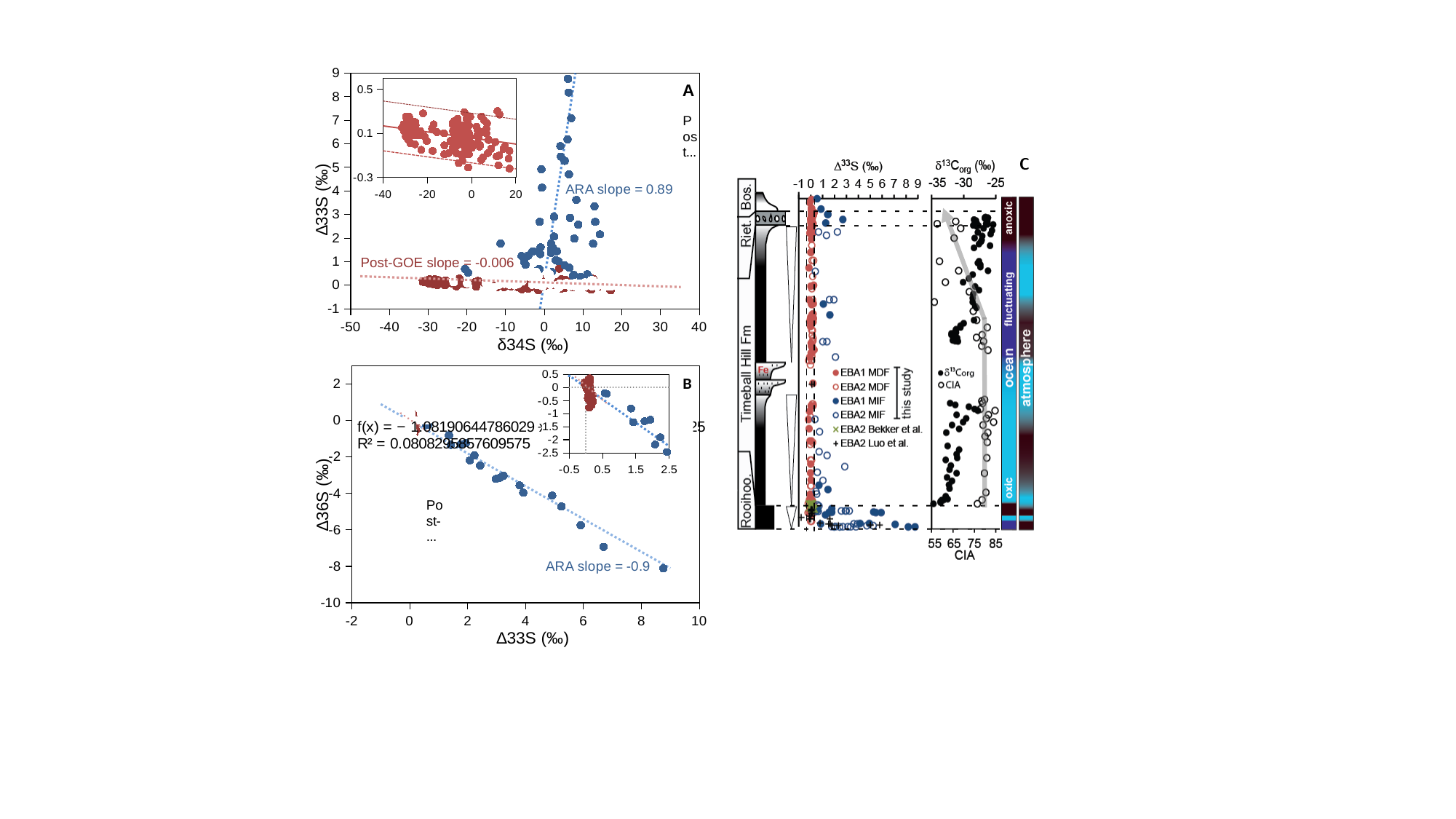
In chart A (top left), what is the maximum value shown on the x axis? 40 In chart B (bottom left), what R² value is printed on the chart? 0.0808295857609575 What is the x-axis label of chart A (top left)? δ34S (‰) In chart A (top left), what is the Post-GOE slope stated on the chart? -0.006 In chart B (bottom left), what is the ARA slope stated on the chart? -0.9 In chart B (bottom left), is the Δ36S value of the rightmost point (near Δ33S = 9) greater or less than -6? less In chart B (bottom left), do the Δ36S values rise or fall as Δ33S increases along the x axis? fall What kind of chart is chart A (top left)? scatter chart In chart A (top left), is the highest Δ33S value plotted greater or less than 8? greater How many entries does the legend in panel C (right) list? 6 What is the y-axis label of chart B (bottom left)? Δ36S (‰) In chart A (top left), what is the ARA slope stated on the chart? 0.89